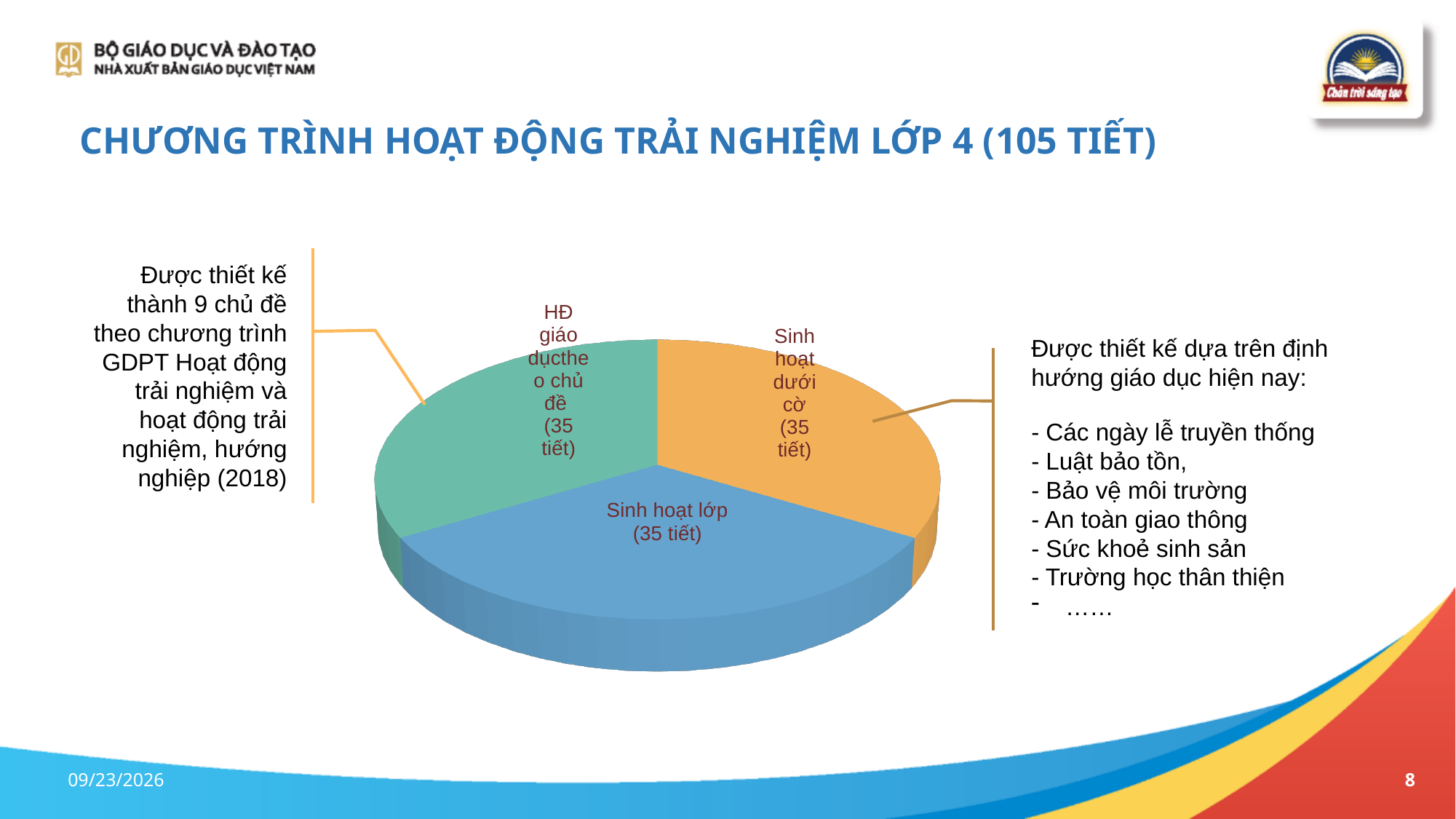
What colour is the Sinh hoạt lớp slice in the pie chart? Blue How many tiết are allocated to Sinh hoạt lớp in the pie chart? 35 tiết What kind of chart is shown on the slide? Pie chart What is the difference in tiết between HĐ giáo dục theo chủ đề and Sinh hoạt lớp? 0 tiết How many tiết are allocated to HĐ giáo dục theo chủ đề in the pie chart? 35 tiết Is the value for Sinh hoạt lớp larger than, smaller than, or equal to the value for Sinh hoạt dưới cờ? Equal How many tiết are allocated to Sinh hoạt dưới cờ in the pie chart? 35 tiết How many slices does the pie chart have? 3 What share of the total tiết does the Sinh hoạt lớp slice represent? One third What is the total number of tiết across all three slices of the pie chart? 105 tiết What is the title of the slide containing the pie chart? CHƯƠNG TRÌNH HOẠT ĐỘNG TRẢI NGHIỆM LỚP 4 (105 TIẾT)